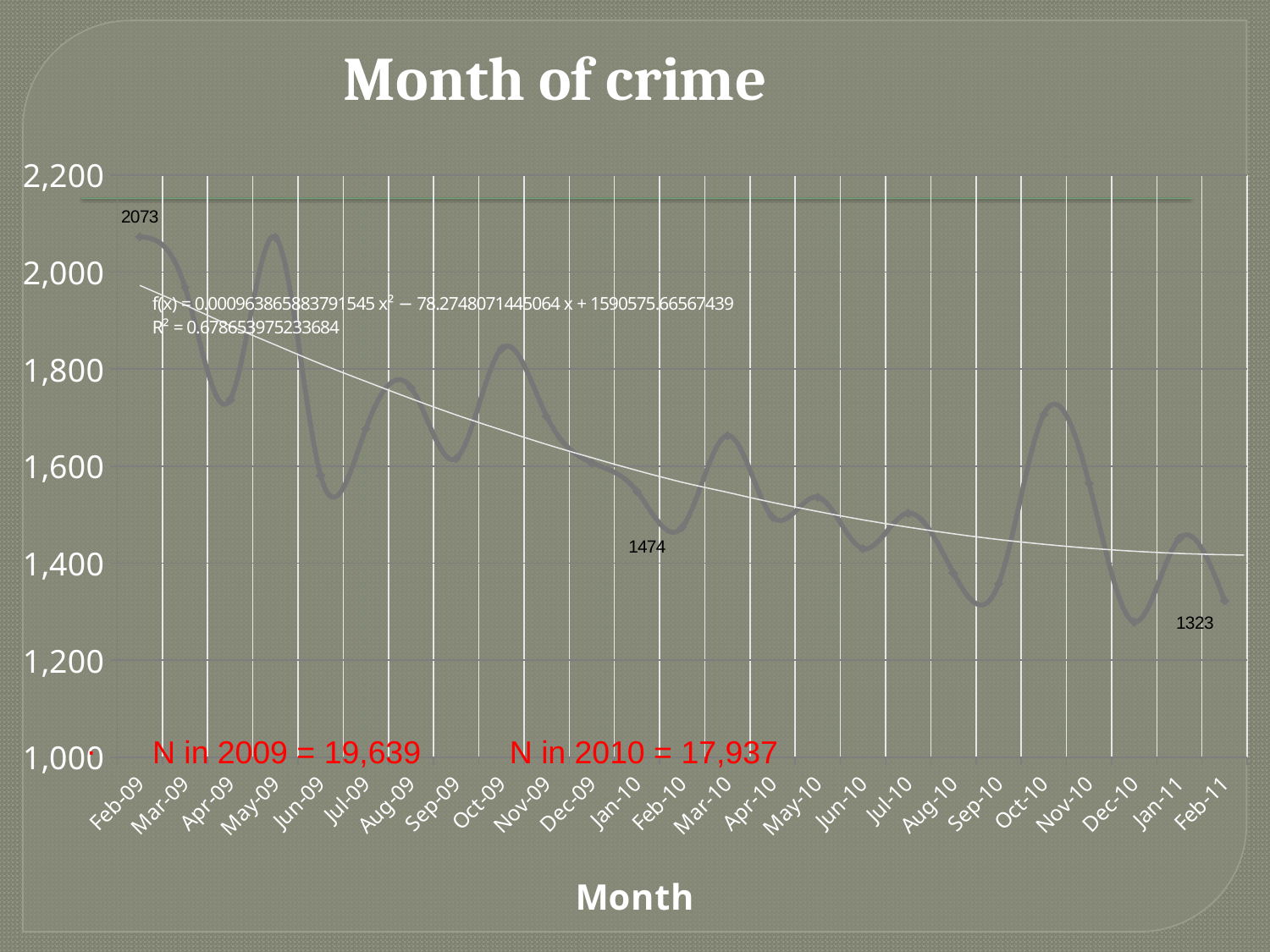
Is the value for Feb-11 greater or less than 1,400? less What is the title of the chart? Month of crime What is the difference between the values for Feb-09 and Feb-11? 750 According to the text on the chart, what is N in 2010? 17,937 How many months are shown on the x axis? 25 What is the value for Feb-11? 1323 Is the value for Feb-09 greater or less than 2,000? greater What type of chart is shown on the slide? line chart Do the values generally rise or fall from Feb-09 to Feb-11? fall What is the value for Feb-09? 2073 Which is larger, the value for Feb-09 or the value for Feb-11? Feb-09